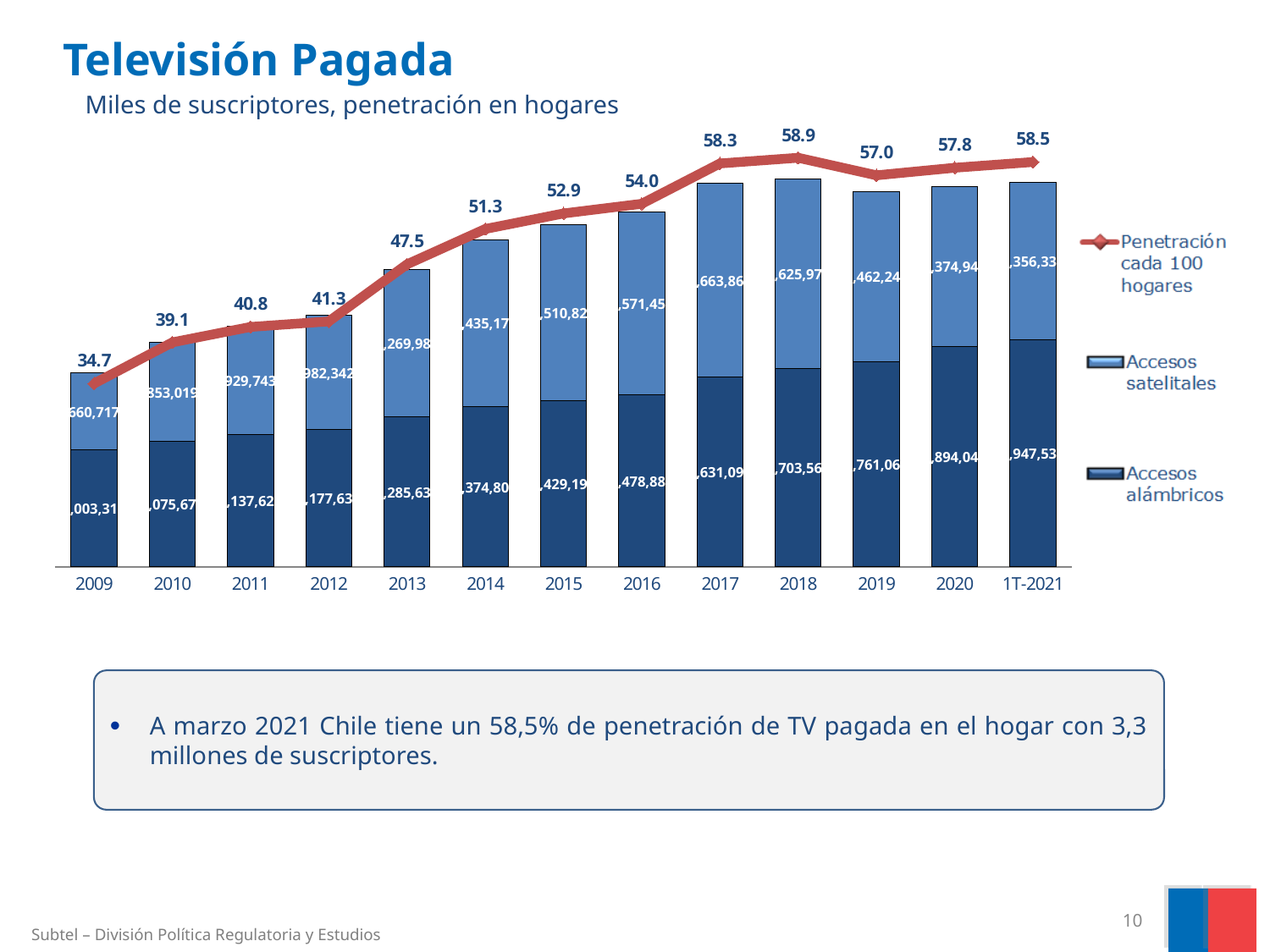
What is the value of Accesos satelitales for 2009? 660,717 What is the overall trend of Penetración cada 100 hogares from 2009 to 2018? Rising What is the difference in Penetración cada 100 hogares between 2018 and 2019? 1.9 What is the value of Accesos satelitales for 2012? 982,342 How many series does the legend list? 3 In which year is Penetración cada 100 hogares highest? 2018 What is the value of Penetración cada 100 hogares for 2016? 54.0 What is the value of Penetración cada 100 hogares for 2009? 34.7 How many periods are shown on the x axis? 13 Which year has a higher Penetración cada 100 hogares, 2019 or 2020? 2020 What is the value of Penetración cada 100 hogares for 1T-2021? 58.5 In which year is Penetración cada 100 hogares lowest? 2009